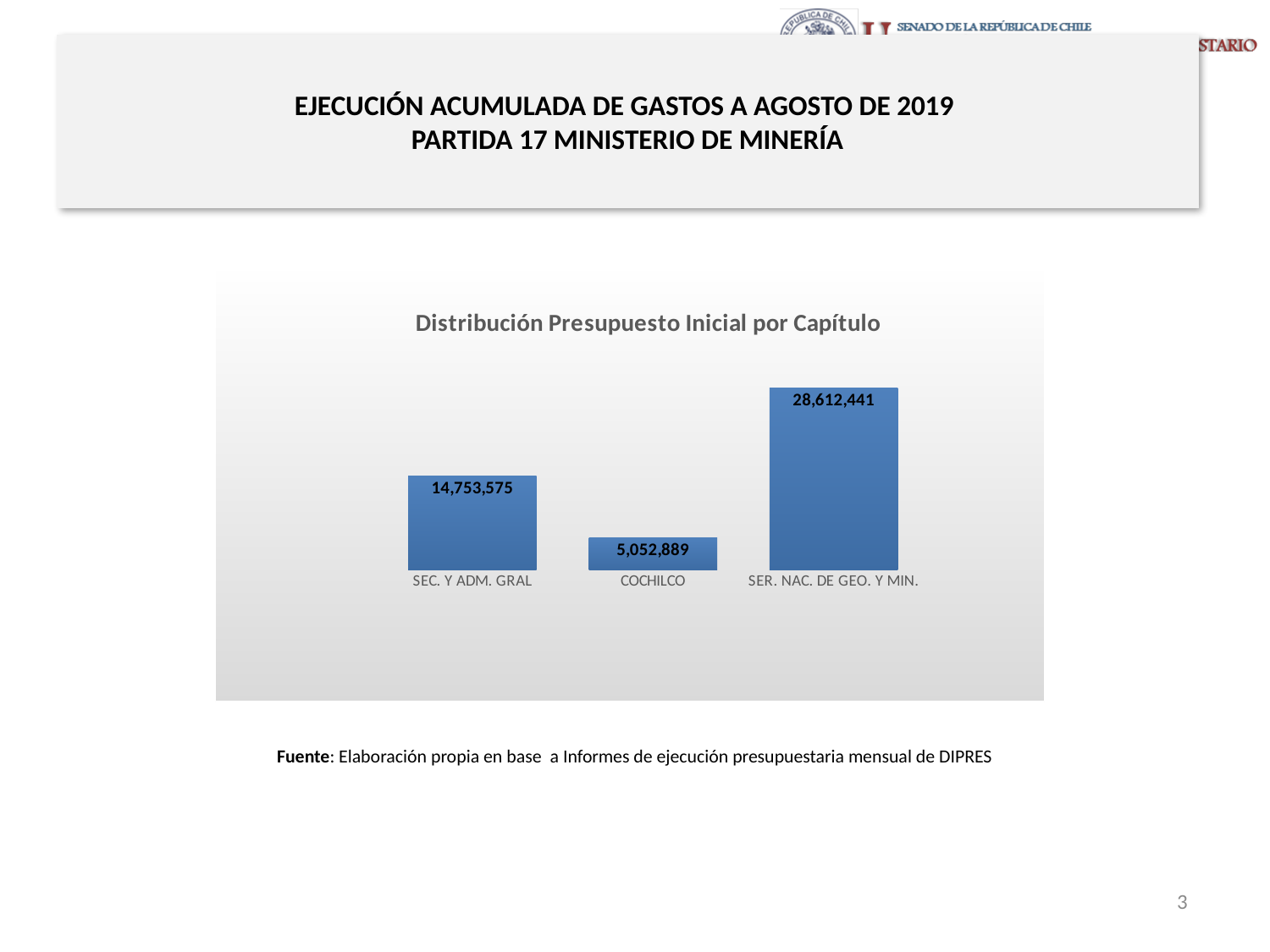
What is the title of the chart? Distribución Presupuesto Inicial por Capítulo What is the difference between the values for SEC. Y ADM. GRAL and COCHILCO? 9,700,686 What is the value for SER. NAC. DE GEO. Y MIN.? 28,612,441 Which is larger, the value for SEC. Y ADM. GRAL or the value for COCHILCO? SEC. Y ADM. GRAL Which category has the highest value? SER. NAC. DE GEO. Y MIN. How many categories are shown in the chart? 3 What kind of chart is shown on the slide? Bar chart What is the difference between the values for SER. NAC. DE GEO. Y MIN. and SEC. Y ADM. GRAL? 13,858,866 What is the value for SEC. Y ADM. GRAL? 14,753,575 What is the value for COCHILCO? 5,052,889 Which category has the lowest value? COCHILCO What is the total of the three values shown in the chart? 48,418,905